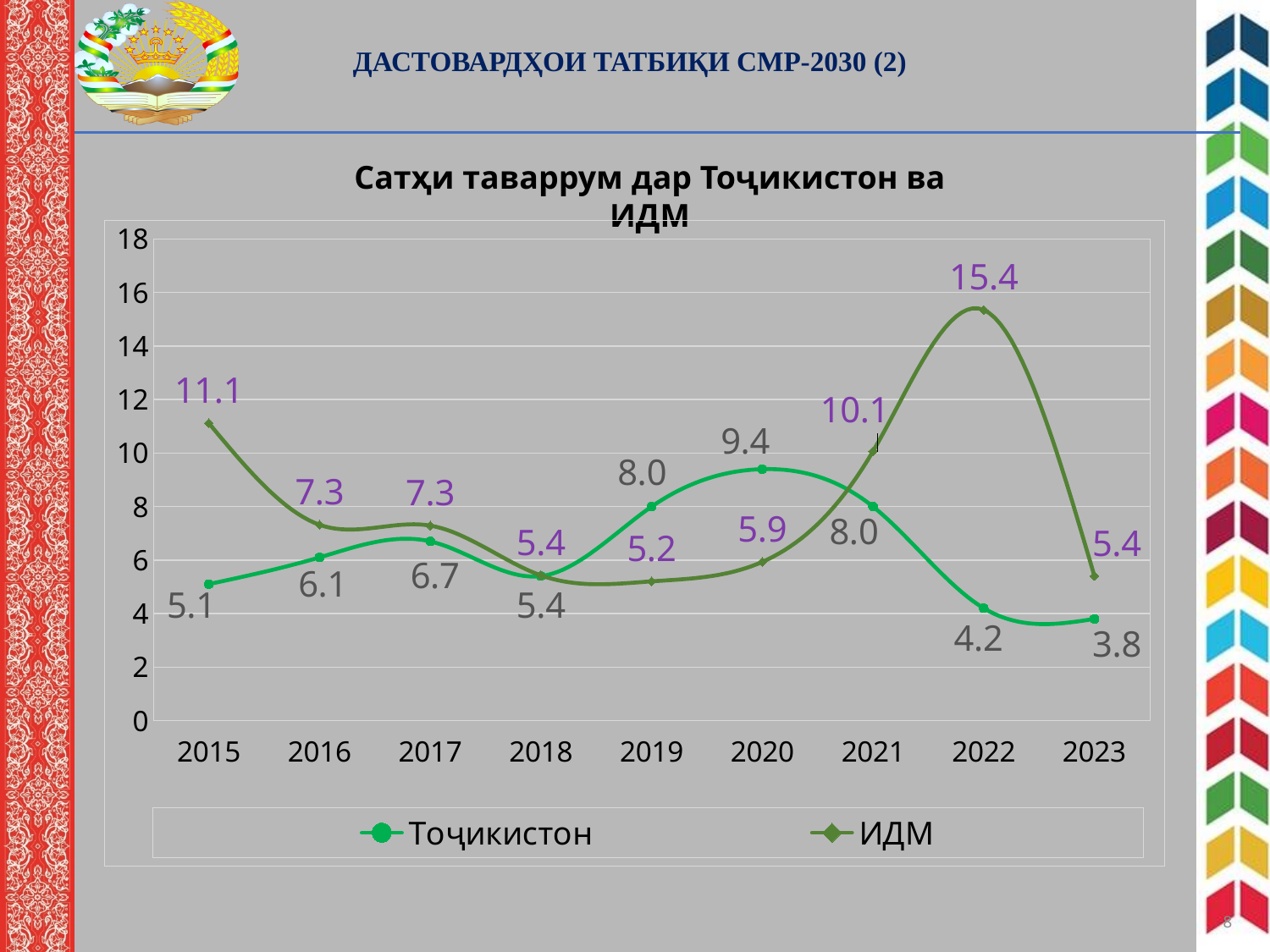
In which year does the Тоҷикистон series have its lowest value? 2023 How many series does the legend list? 2 What is the difference between the ИДМ and Тоҷикистон values in 2022? 11.2 What is the value for ИДМ in 2015? 11.1 What is the value for Тоҷикистон in 2020? 9.4 In which year does the ИДМ series reach its highest value? 2022 How many years are shown on the x axis? 9 What is the value for ИДМ in 2022? 15.4 Which series has the larger value in 2020, Тоҷикистон or ИДМ? Тоҷикистон Does the Тоҷикистон series rise or fall from 2021 to 2023? fall What type of chart is shown on the slide? line chart What is the value for Тоҷикистон in 2023? 3.8